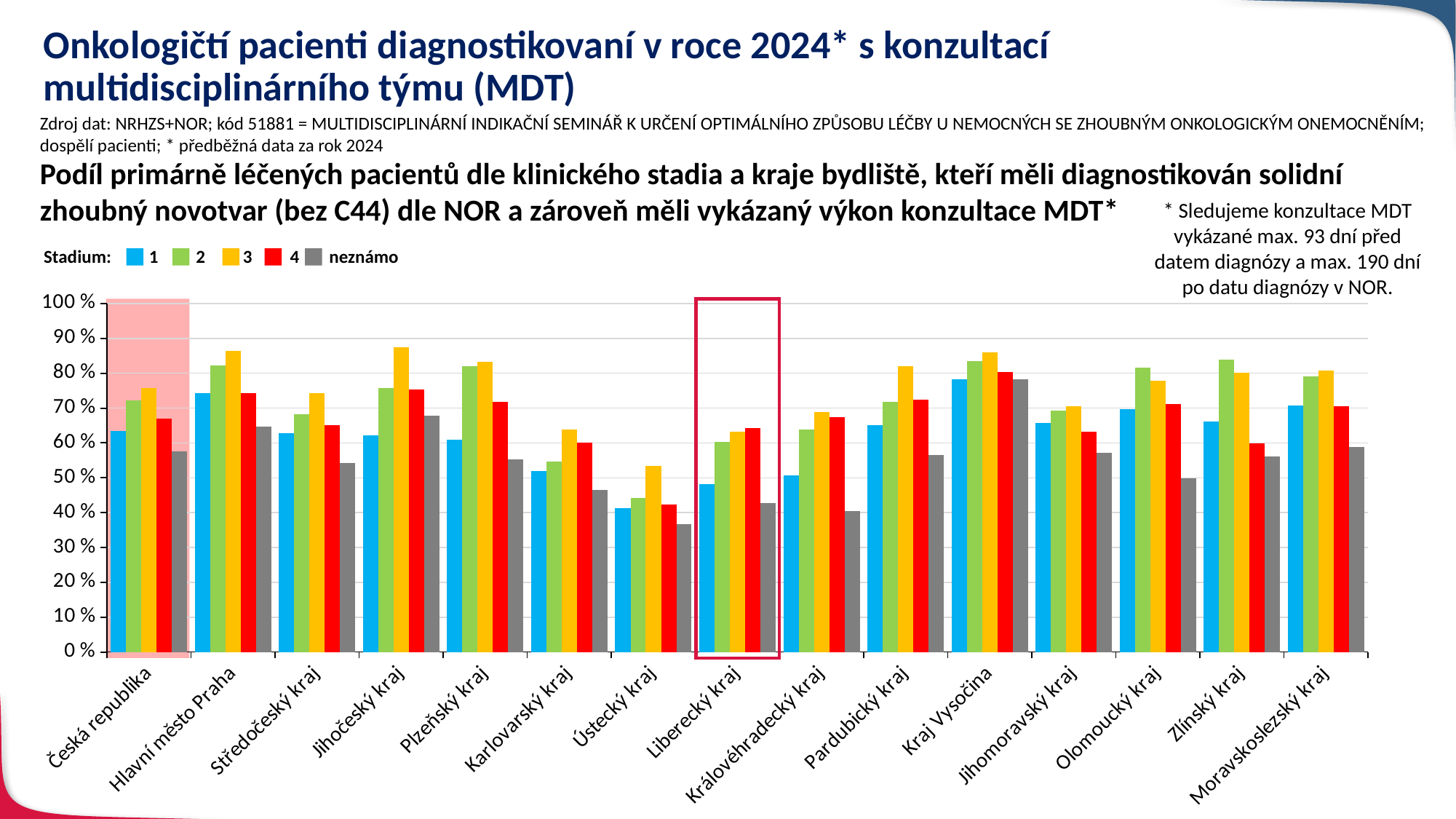
Is the value for 'neznámo' in Královéhradecký kraj greater or less than 50 %? less Is the value for Stadium 1 in Kraj Vysočina greater or less than 70 %? greater Is the value for Stadium 1 in Ústecký kraj greater or less than 50 %? less Which is larger: the Stadium 3 value for Jihočeský kraj or for Karlovarský kraj? Jihočeský kraj Which category is highlighted with a pink shaded background? Česká republika How many series does the legend (Stadium) list? 5 Which region has the highest value for 'neznámo'? Kraj Vysočina Which region has the lowest value for Stadium 1? Ústecký kraj Which region is outlined with a red rectangle? Liberecký kraj How many categories (regions, including Česká republika) are shown on the x axis? 15 What kind of chart is shown on the slide? bar chart